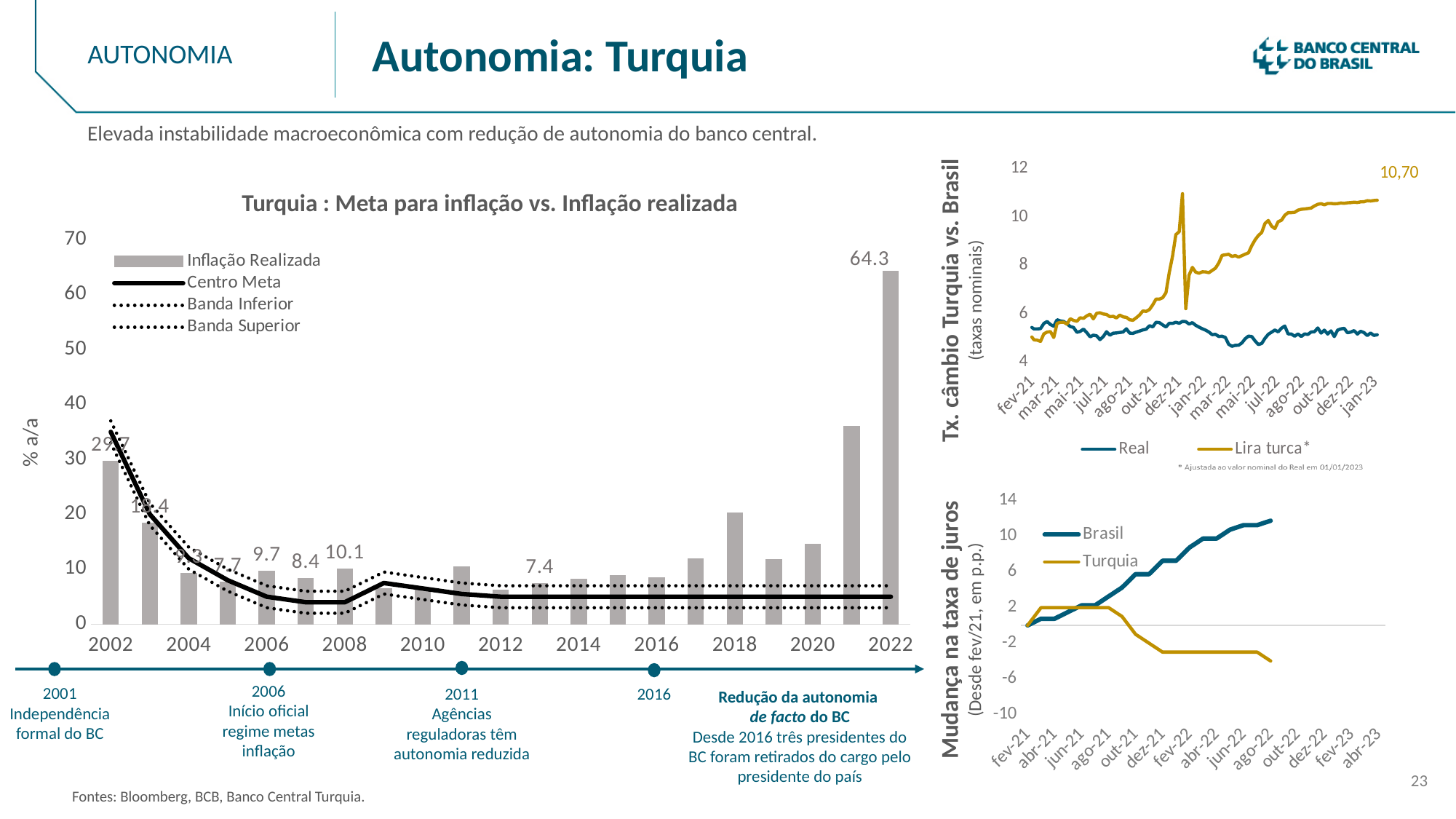
In the chart 'Turquia : Meta para inflação vs. Inflação realizada', what is the value of Inflação Realizada for 2022? 64.3 What kind of chart is 'Tx. câmbio Turquia vs. Brasil'? line chart In the chart 'Turquia : Meta para inflação vs. Inflação realizada', what is the value of Inflação Realizada for 2002? 29.7 How many entries does the legend of the chart 'Turquia : Meta para inflação vs. Inflação realizada' list? 4 In the chart 'Mudança na taxa de juros', is the value for Turquia at ago-22 greater or less than -2? less In the chart 'Turquia : Meta para inflação vs. Inflação realizada', what is the value of Inflação Realizada for 2008? 10.1 In the chart 'Turquia : Meta para inflação vs. Inflação realizada', what is the difference between the Inflação Realizada values for 2022 and 2002? 34.6 In the chart 'Turquia : Meta para inflação vs. Inflação realizada', is the Inflação Realizada value for 2021 greater or less than 30? greater In the chart 'Turquia : Meta para inflação vs. Inflação realizada', which year has the larger Inflação Realizada, 2006 or 2007? 2006 In the chart 'Mudança na taxa de juros', does the Brasil series rise or fall from fev-21 to ago-22? rise In the chart 'Turquia : Meta para inflação vs. Inflação realizada', which year has the highest Inflação Realizada? 2022 In the chart 'Tx. câmbio Turquia vs. Brasil', what value is labelled at the end of the Lira turca series? 10,70